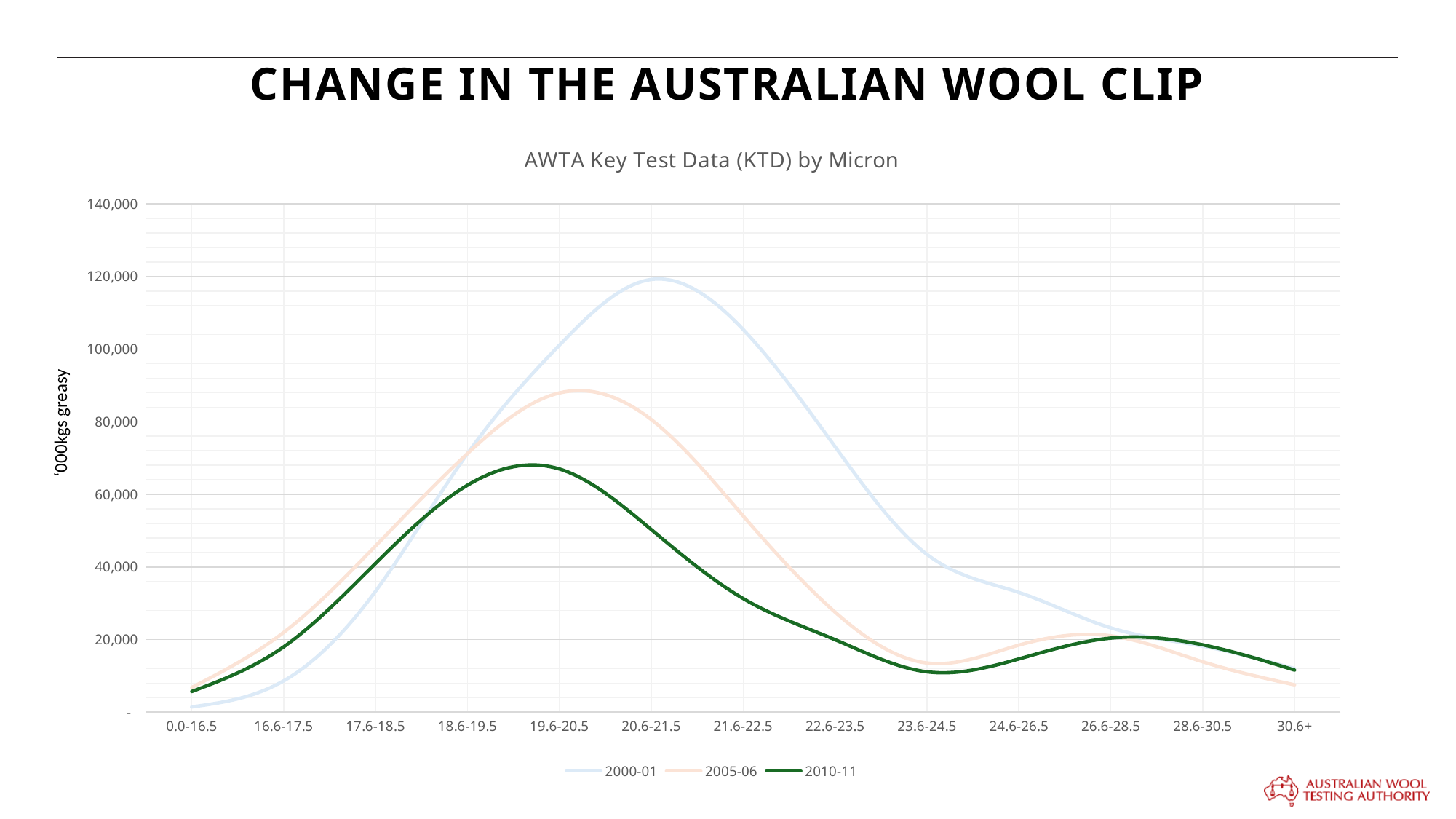
Is the value for 2000-01 at 20.6-21.5 greater or less than 100,000? greater In which micron category does the 2010-11 series reach its highest value? 19.6-20.5 How many micron categories are shown on the x axis? 13 What is the label on the y axis? '000kgs greasy What kind of chart is shown on the slide? line chart Is the value for 2010-11 at 19.6-20.5 greater or less than 60,000? greater At 17.6-18.5, which series has the larger value, 2005-06 or 2000-01? 2005-06 In which micron category does the 2000-01 series reach its highest value? 20.6-21.5 Does the 2000-01 series rise or fall from 20.6-21.5 to 23.6-24.5? fall Is the value for 2005-06 at 23.6-24.5 greater or less than 20,000? less At 20.6-21.5, which series has the larger value, 2000-01 or 2010-11? 2000-01 How many series does the legend list? 3